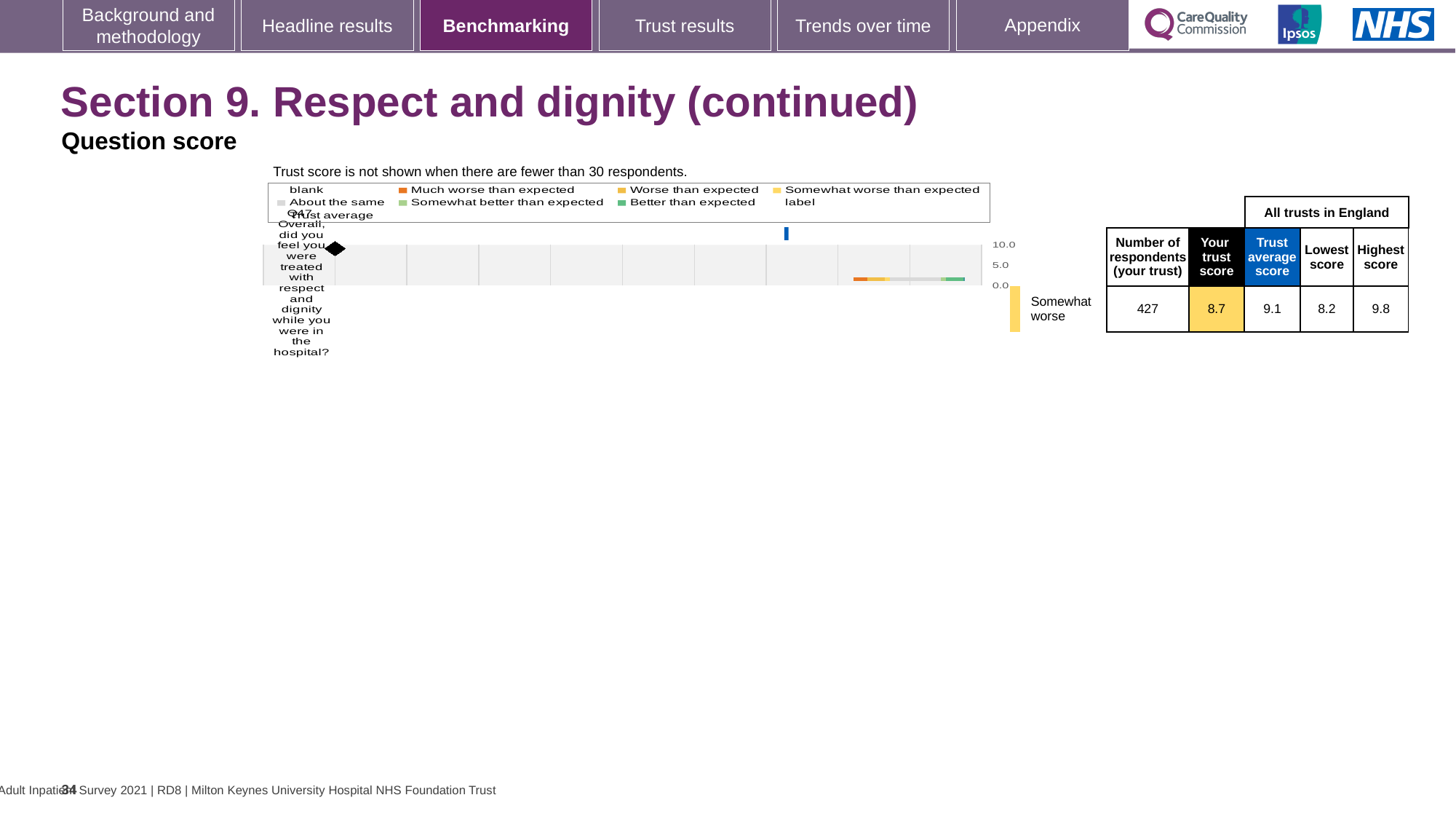
What benchmark category label is shown next to the chart for Q47? Somewhat worse What is the highest tick value shown on the chart's value axis? 10.0 Which question number is plotted on the chart? Q47 According to the table beside the chart, what is the lowest score among all trusts in England for Q47? 8.2 Which is larger for Q47: your trust score or the trust average score? Trust average score According to the table beside the chart, what is your trust score for Q47? 8.7 What kind of chart is shown on the slide? bar chart According to the table beside the chart, what is the trust average score for all trusts in England for Q47? 9.1 According to the table beside the chart, what is the highest score among all trusts in England for Q47? 9.8 What is the difference between the highest score and the lowest score for Q47 in the table beside the chart? 1.6 How many questions (categories) are plotted on the chart? 1 According to the table beside the chart, what is the number of respondents for your trust for Q47? 427